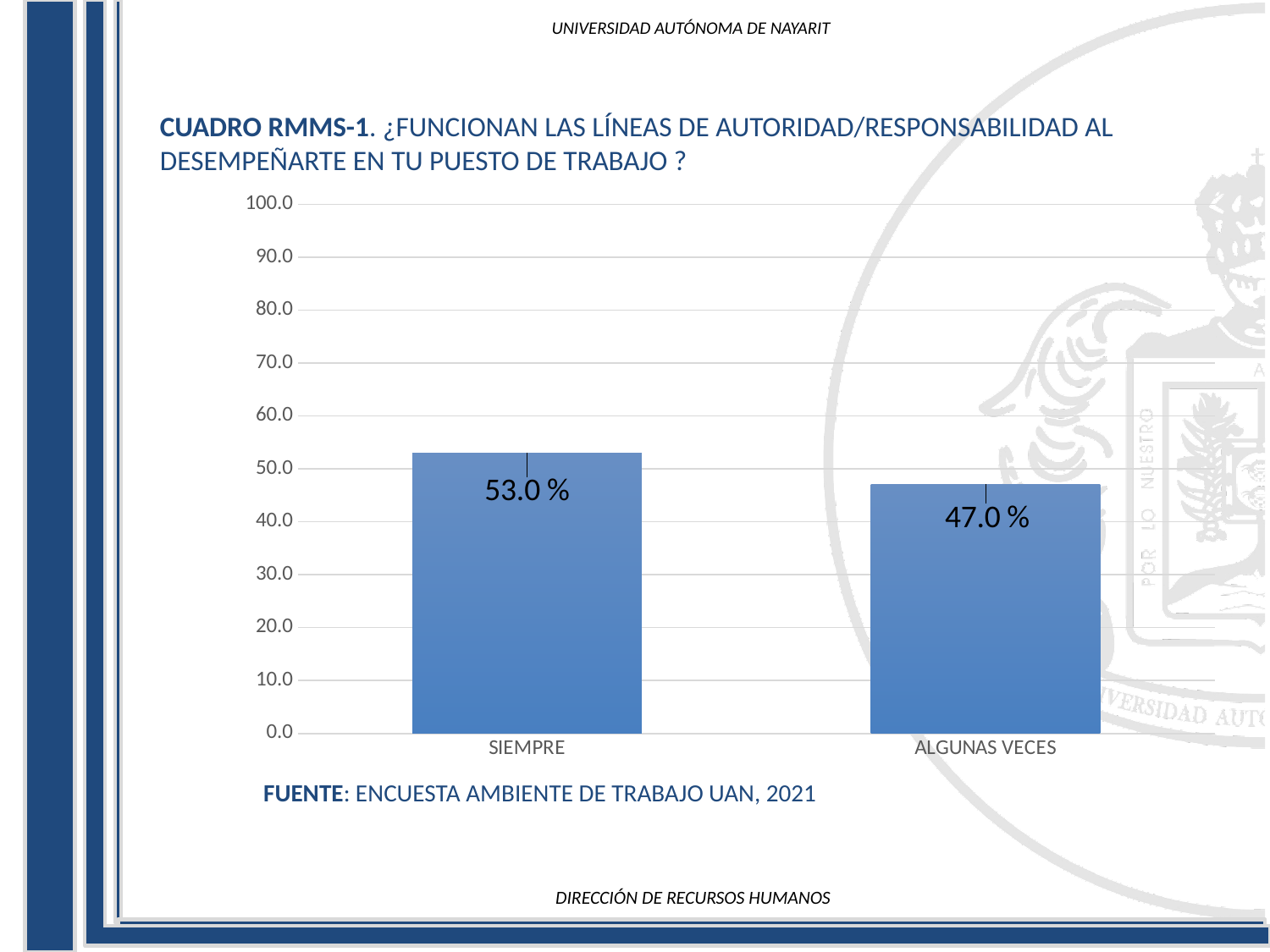
Which is larger, the value for SIEMPRE or the value for ALGUNAS VECES? SIEMPRE What is the total of the two bar values? 100.0 % Which category has the lowest value? ALGUNAS VECES Is the value for SIEMPRE greater or less than 50.0? greater Which category has the highest value? SIEMPRE Is the value for ALGUNAS VECES greater or less than 50.0? less What is the difference between the values for SIEMPRE and ALGUNAS VECES? 6.0 % How many categories are shown on the x axis? 2 What is the maximum value shown on the y axis? 100.0 What is the value for SIEMPRE? 53.0 % What is the value for ALGUNAS VECES? 47.0 % What kind of chart is shown on the slide? bar chart